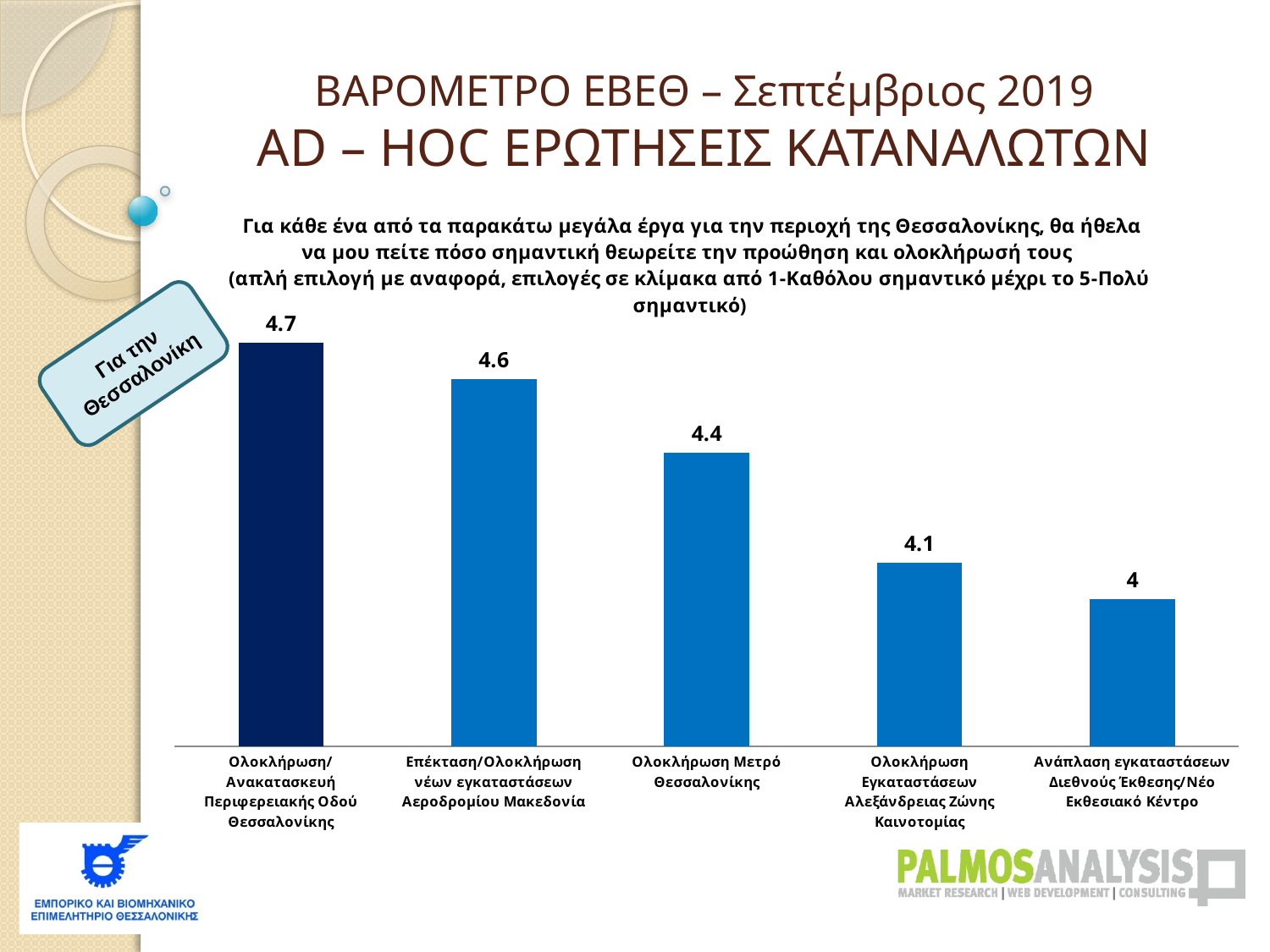
Which category has the highest value? Ολοκλήρωση/Ανακατασκευή Περιφερειακής Οδού Θεσσαλονίκης What kind of chart is shown on the slide? Bar chart What is the difference between the values for Ολοκλήρωση/Ανακατασκευή Περιφερειακής Οδού Θεσσαλονίκης and Ολοκλήρωση Εγκαταστάσεων Αλεξάνδρειας Ζώνης Καινοτομίας? 0.6 Which bar is coloured differently (dark navy) from the others? Ολοκλήρωση/Ανακατασκευή Περιφερειακής Οδού Θεσσαλονίκης Do the values rise or fall from left to right across the categories? Fall Which category has the lowest value? Ανάπλαση εγκαταστάσεων Διεθνούς Έκθεσης/Νέο Εκθεσιακό Κέντρο How many categories are shown in the chart? 5 What is the value for Επέκταση/Ολοκλήρωση νέων εγκαταστάσεων Αεροδρομίου Μακεδονία? 4.6 Which is larger: the value for Ολοκλήρωση Μετρό Θεσσαλονίκης or the value for Ολοκλήρωση Εγκαταστάσεων Αλεξάνδρειας Ζώνης Καινοτομίας? Ολοκλήρωση Μετρό Θεσσαλονίκης What is the value for Ανάπλαση εγκαταστάσεων Διεθνούς Έκθεσης/Νέο Εκθεσιακό Κέντρο? 4 What is the value for Ολοκλήρωση Εγκαταστάσεων Αλεξάνδρειας Ζώνης Καινοτομίας? 4.1 What is the value for Ολοκλήρωση Μετρό Θεσσαλονίκης? 4.4